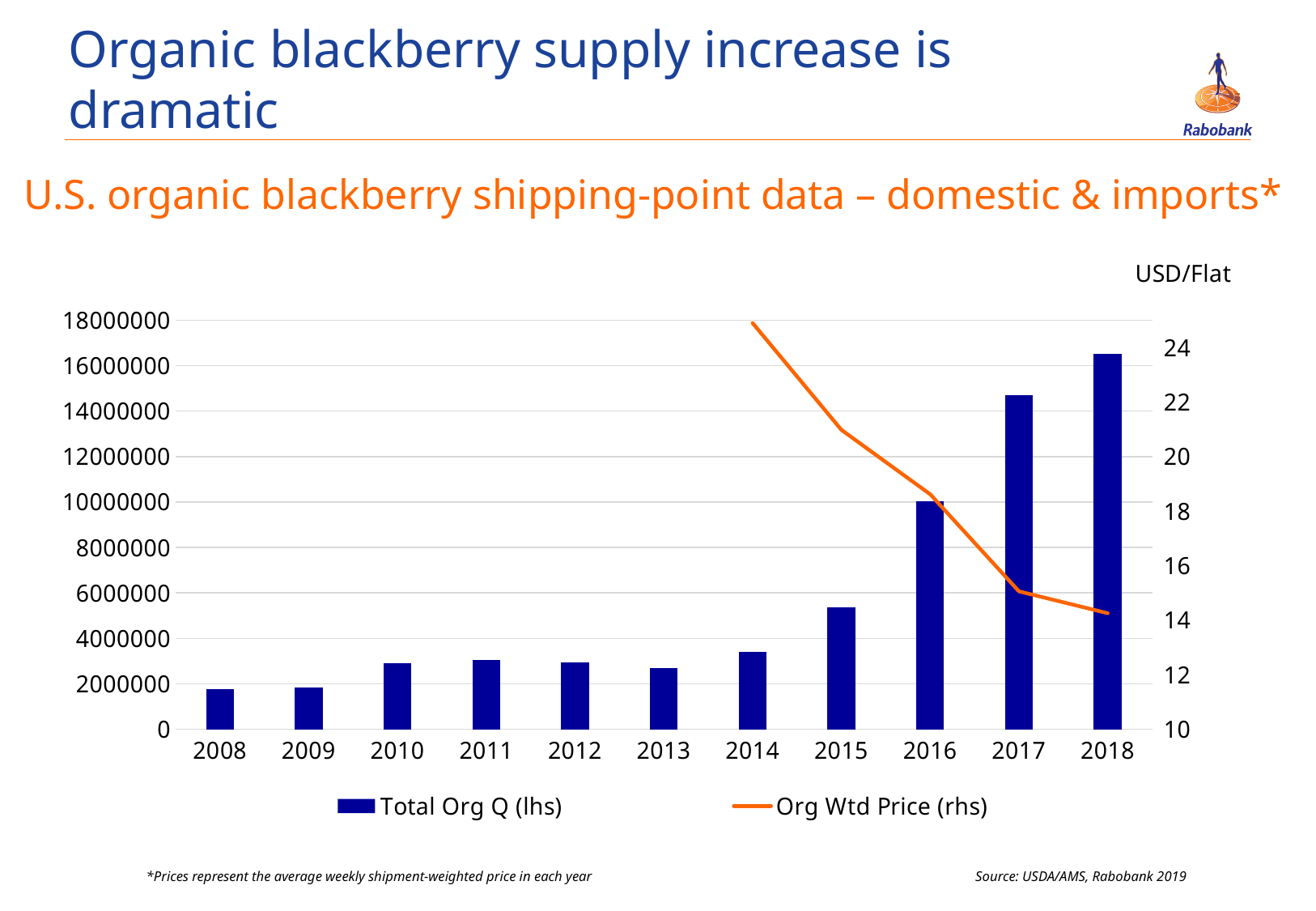
How many series does the legend list? 2 Which year has the lowest Total Org Q bar? 2008 Is the Total Org Q value for 2013 greater or less than 4000000? less Which year has the highest Total Org Q bar? 2018 Which year has the larger Total Org Q bar, 2016 or 2017? 2017 Does the Org Wtd Price line rise or fall from 2014 to 2018? It falls What unit is shown above the right-hand axis of the chart? USD/Flat What kind of chart is shown on the slide? A bar chart with a line overlay How many years are shown on the x axis of the chart? 11 Is the Total Org Q value for 2018 greater or less than 16000000? greater Do the Total Org Q bars generally rise or fall from 2013 to 2018? They rise Is the Org Wtd Price value for 2018 greater or less than 16? less